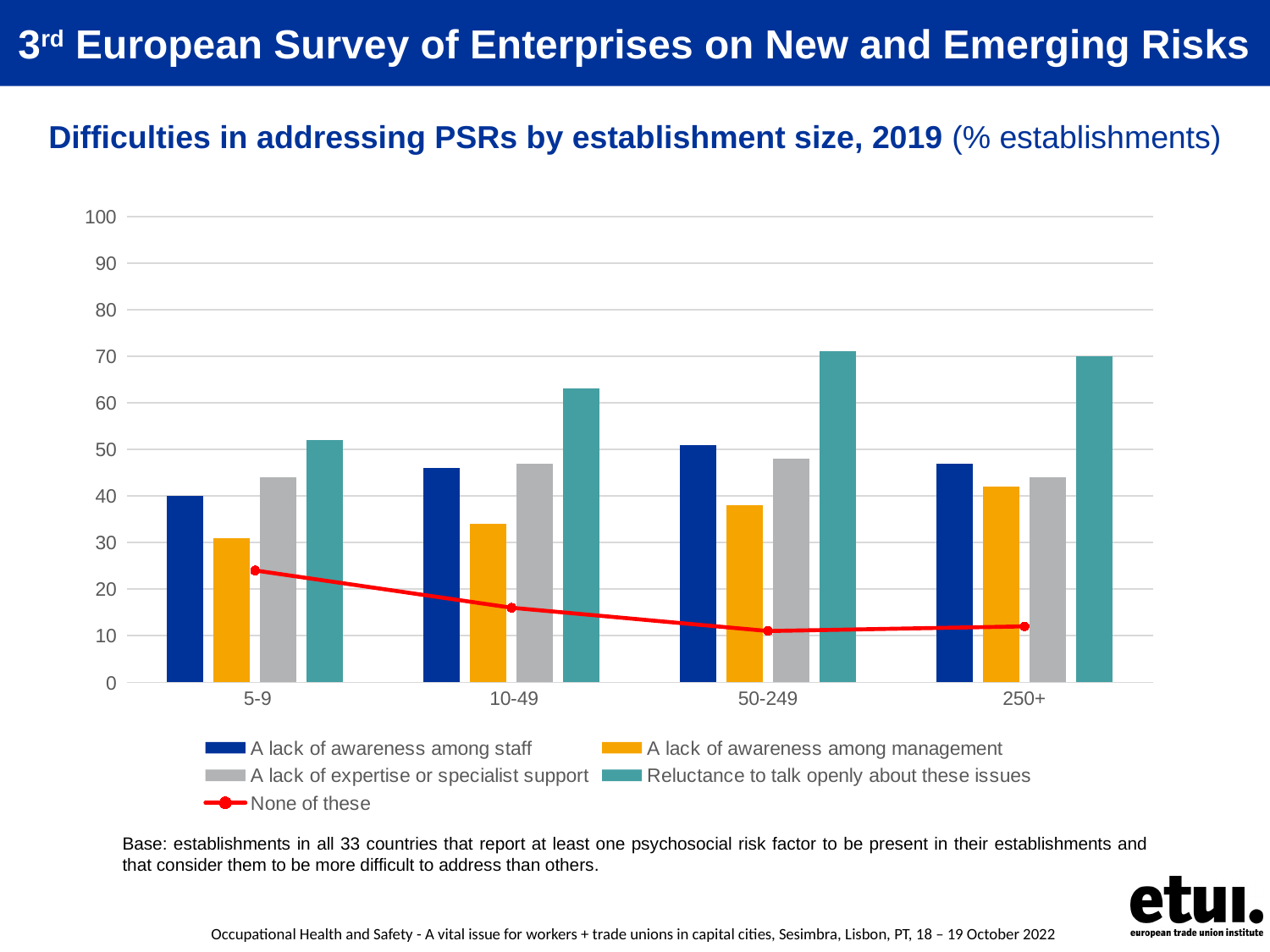
Does the value for 'Reluctance to talk openly about these issues' rise or fall from 5-9 to 50-249? rise What kind of chart is shown on the slide? bar chart with a line What colour is the 'None of these' line? red Is the value for 'Reluctance to talk openly about these issues' at 50-249 greater or less than 60? greater For the 50-249 establishment size, which series has the highest value? Reluctance to talk openly about these issues For which establishment size is the value for 'A lack of awareness among management' lowest? 5-9 How many establishment size categories are shown on the x axis? 4 For the 250+ establishment size, which is larger: 'A lack of awareness among staff' or 'A lack of awareness among management'? A lack of awareness among staff Is the value for 'None of these' at 5-9 greater or less than 20? greater Does the 'None of these' line rise or fall from 5-9 to 50-249? fall How many series does the legend list? 5 Is the value for 'A lack of awareness among management' at 5-9 greater or less than 40? less